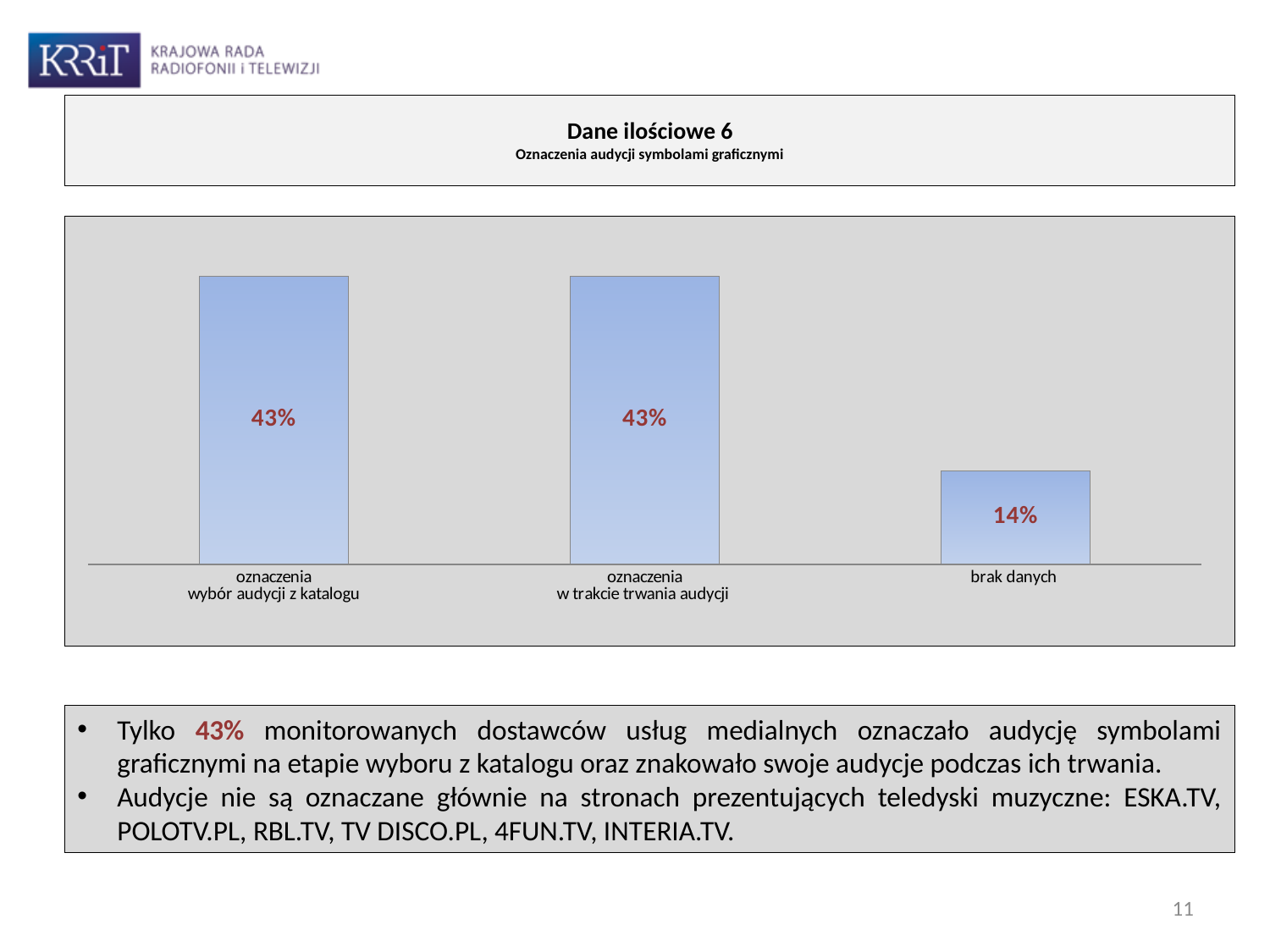
What is the value for "brak danych"? 14% What is the value for "oznaczenia wybór audycji z katalogu"? 43% What is the difference between the value for "oznaczenia wybór audycji z katalogu" and the value for "brak danych"? 29% What is the subtitle shown under "Dane ilościowe 6"? Oznaczenia audycji symbolami graficznymi What is the value for "oznaczenia w trakcie trwania audycji"? 43% Do the two "oznaczenia" categories have the same value? Yes What kind of chart is shown on the slide? bar chart Which category has the lowest value? brak danych How many categories are shown in the chart? 3 What is the title of the slide above the chart? Dane ilościowe 6 Which is larger: the value for "oznaczenia w trakcie trwania audycji" or the value for "brak danych"? oznaczenia w trakcie trwania audycji What is the total of the three values shown in the chart? 100%